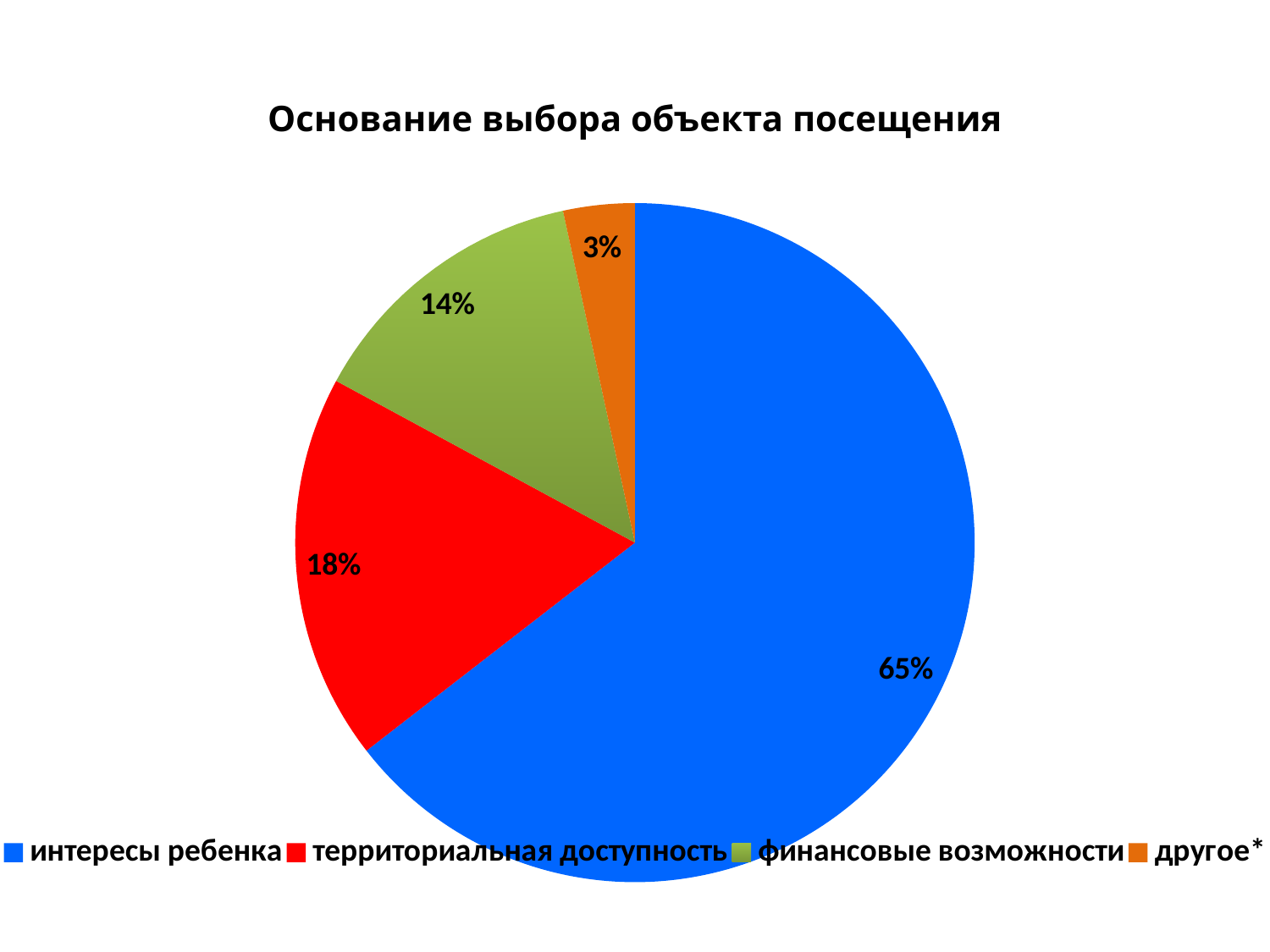
Which category has the smallest slice of the pie? другое* What share of the pie is labelled for интересы ребенка? 65% What is the difference in percentage points between интересы ребенка and территориальная доступность? 47 What colour is the slice for финансовые возможности? green What share of the pie is labelled for финансовые возможности? 14% What is the title of the chart? Основание выбора объекта посещения What share of the pie is labelled for территориальная доступность? 18% How many categories does the pie chart have? 4 What share of the pie is labelled for другое*? 3% Which category has the largest slice of the pie? интересы ребенка Which is larger: территориальная доступность or финансовые возможности? территориальная доступность What kind of chart is shown on the slide? pie chart